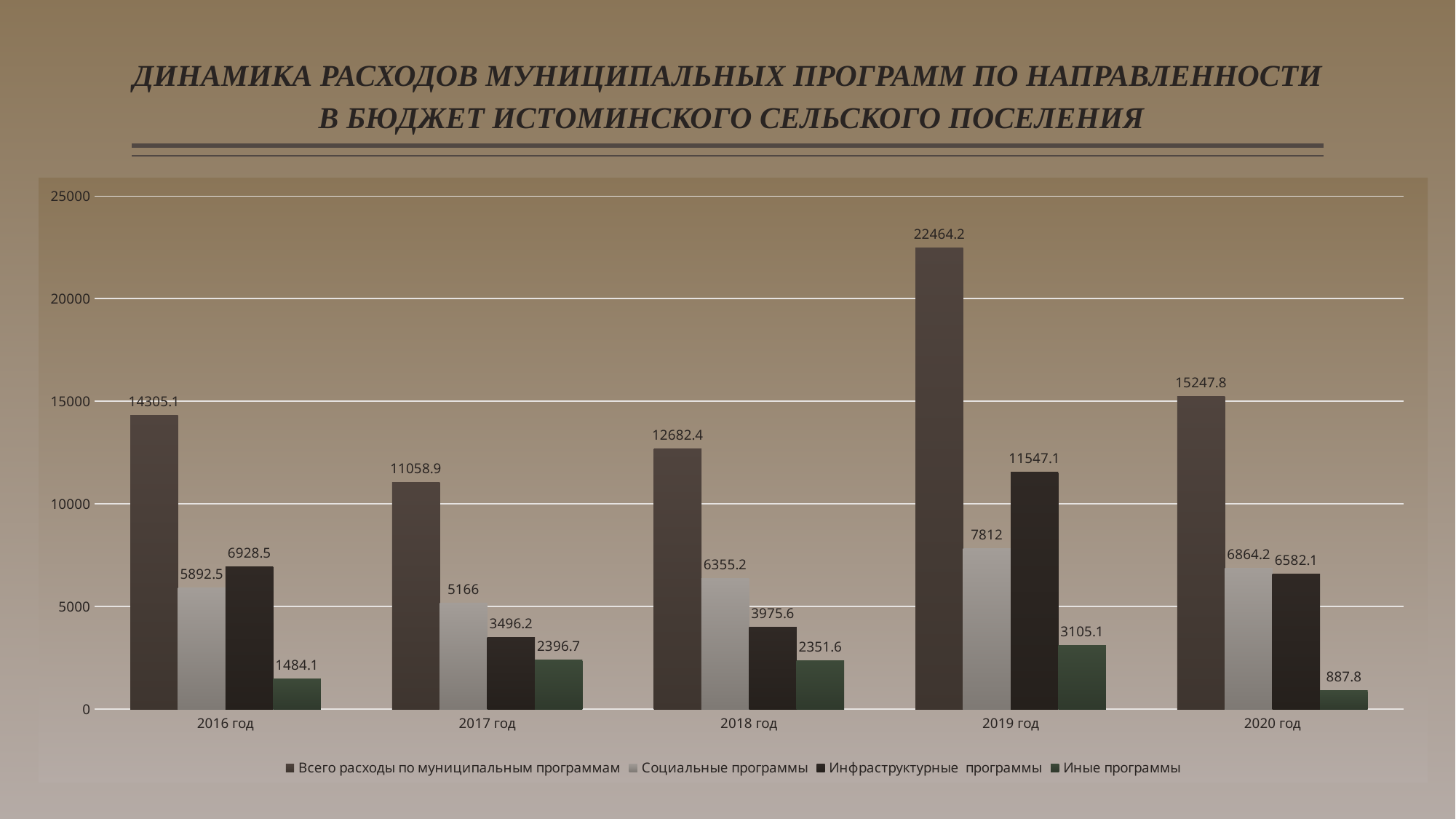
In which year is "Всего расходы по муниципальным программам" the highest? 2019 год Does "Социальные программы" rise or fall from 2017 год to 2019 год? Rise What is the value of "Иные программы" for 2020 год? 887.8 What kind of chart is shown on the slide? Bar chart What is the value of "Всего расходы по муниципальным программам" for 2019 год? 22464.2 Which is larger in 2016 год: "Социальные программы" or "Инфраструктурные программы"? Инфраструктурные программы How many years are shown on the x axis? 5 How many series does the legend list? 4 What is the value of "Инфраструктурные программы" for 2018 год? 3975.6 In which year is "Иные программы" the lowest? 2020 год What is the value of "Социальные программы" for 2017 год? 5166 What is the difference between "Всего расходы по муниципальным программам" in 2020 год and in 2016 год? 942.7